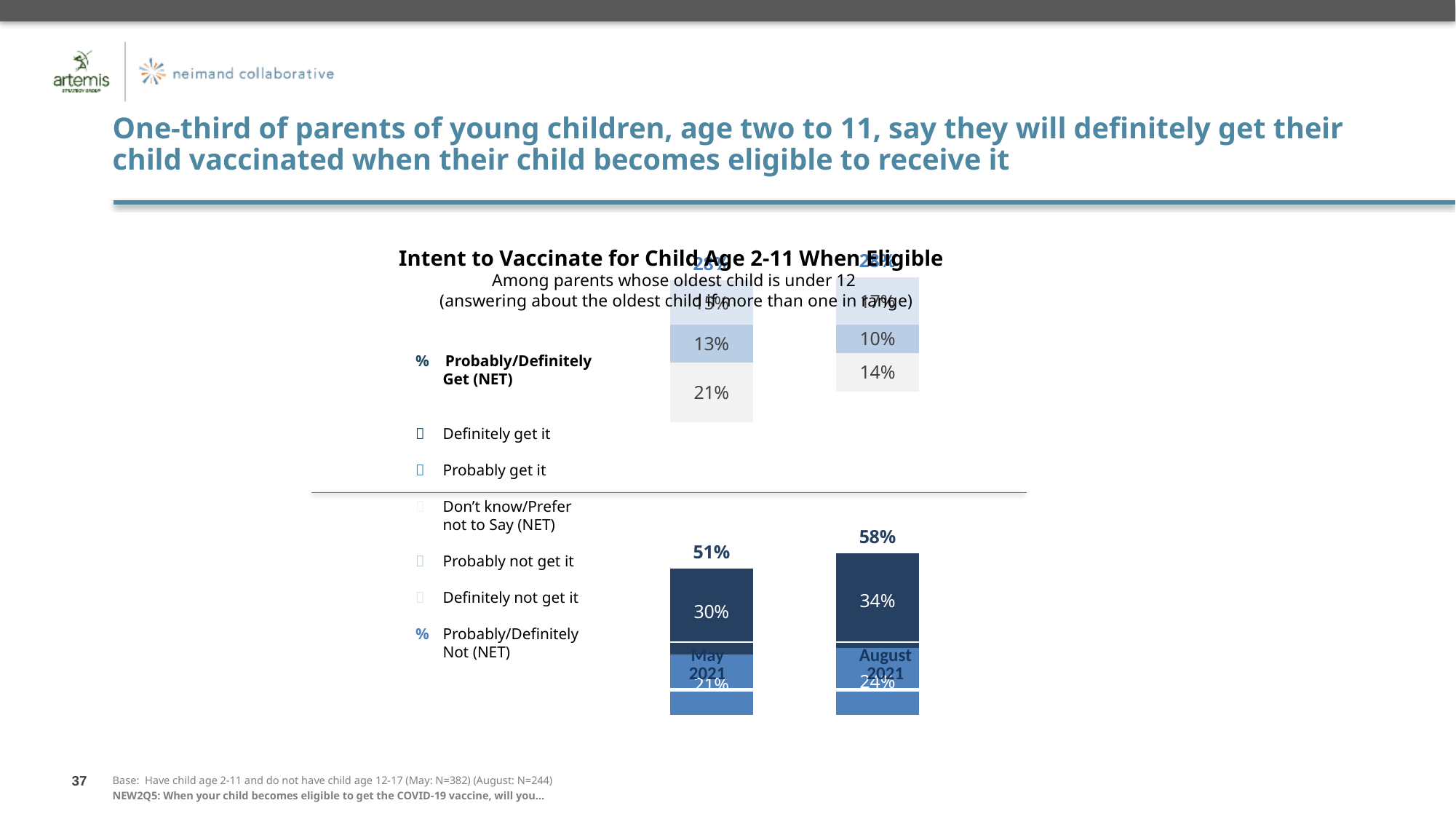
What percentage of parents said they would probably get their child vaccinated in August 2021? 24% By how many percentage points did 'Definitely get it' change from May 2021 to August 2021? 4 percentage points What is the Probably/Definitely Get (NET) value for August 2021? 58% What percentage of parents said they would definitely get their child vaccinated in August 2021? 34% How many time periods (bars) are shown in the chart? 2 What is the title of the chart? Intent to Vaccinate for Child Age 2-11 When Eligible What kind of chart is shown on the slide? Stacked bar chart Does the Probably/Definitely Get (NET) value rise or fall from May 2021 to August 2021? Rise What percentage of parents said they would probably get their child vaccinated in May 2021? 21% Which period has the higher Probably/Definitely Get (NET) value, May 2021 or August 2021? August 2021 What percentage of parents said they would definitely get their child vaccinated in May 2021? 30% What is the Probably/Definitely Get (NET) value for May 2021? 51%